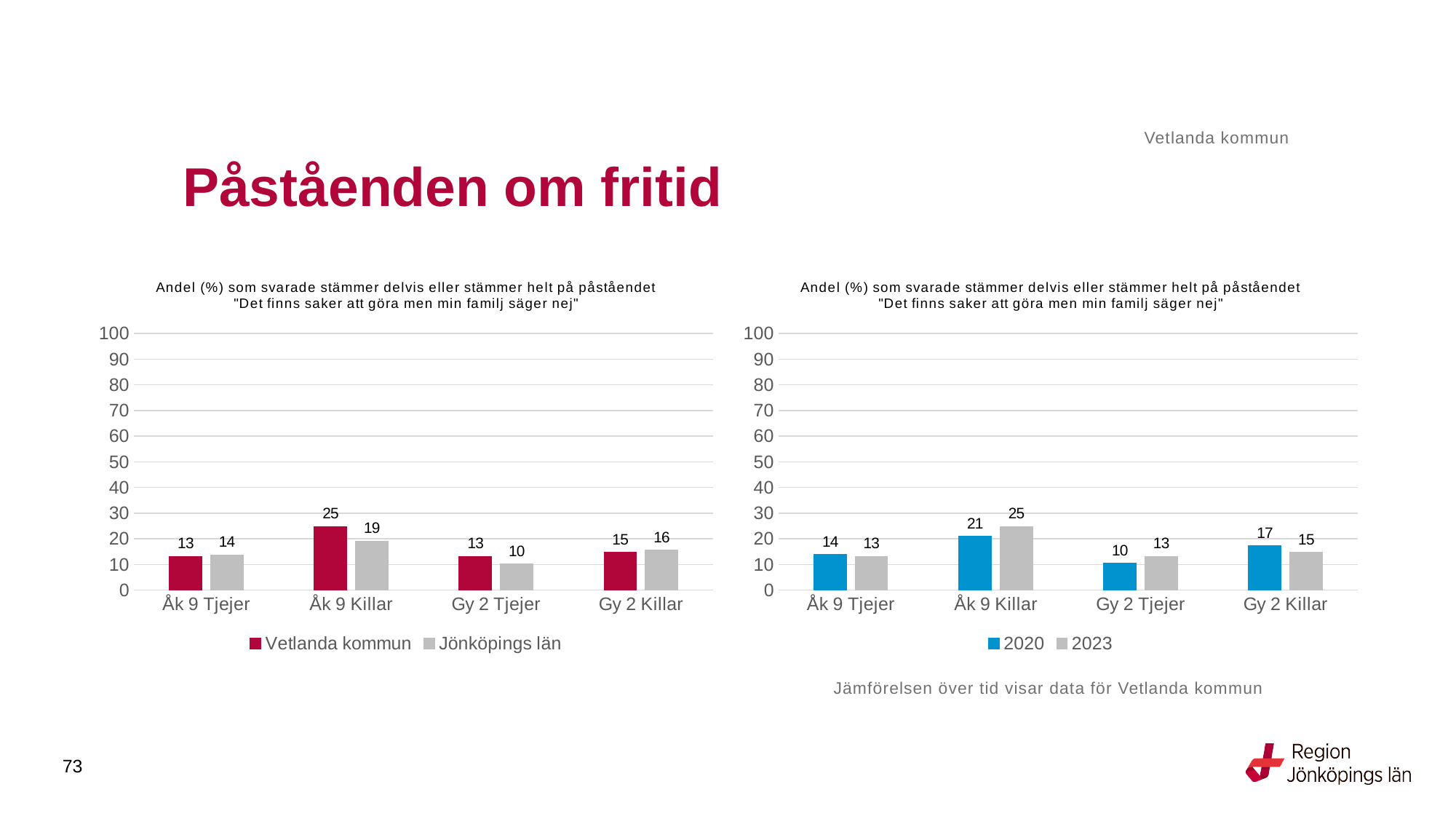
What type of chart is the left chart? Bar chart In the left chart, which is larger for Gy 2 Killar: Vetlanda kommun or Jönköpings län? Jönköpings län In the left chart, which category has the highest value for Vetlanda kommun? Åk 9 Killar In the right chart, what is the 2020 value for Gy 2 Killar? 17 In the right chart, what is the 2023 value for Åk 9 Killar? 25 In the left chart, what is the value for Vetlanda kommun for Åk 9 Killar? 25 In the right chart, which category has the lowest 2020 value? Gy 2 Tjejer In the right chart, what is the difference between the 2023 and 2020 values for Åk 9 Killar? 4 How many series does the legend of the left chart list? 2 In the left chart, what is the difference between Vetlanda kommun and Jönköpings län for Åk 9 Killar? 6 How many categories are shown on the x axis of the right chart? 4 In the left chart, what is the value for Jönköpings län for Gy 2 Tjejer? 10